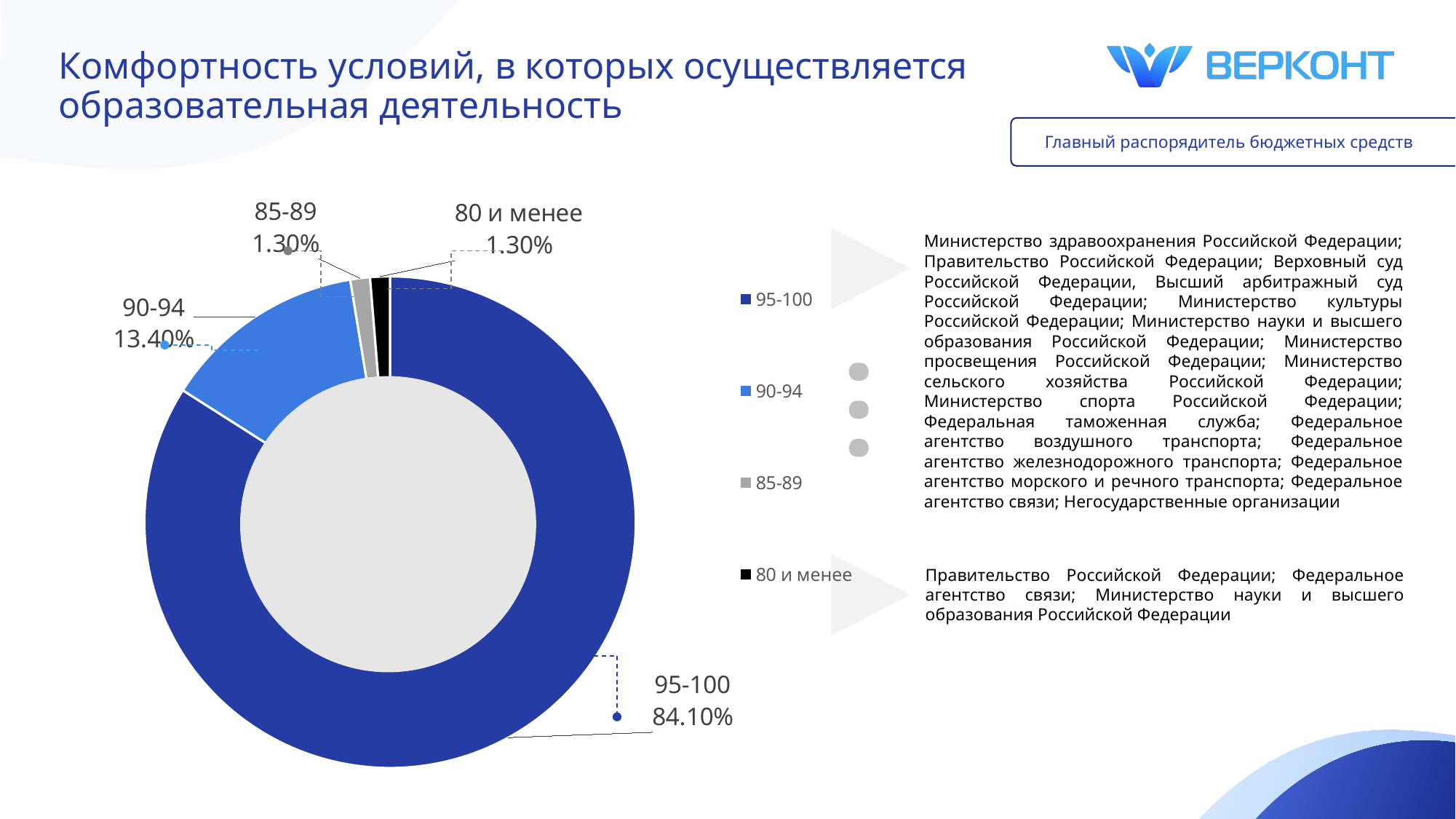
How many categories are shown in the chart? 4 How many entries does the chart legend list? 4 What is the difference between the shares of the 95-100 and 90-94 categories? 70.70% What colour is the slice for the '80 и менее' category? black What kind of chart is shown on the slide? doughnut chart What is the value shown for the 90-94 category? 13.40% What is the value shown for the 85-89 category? 1.30% What share of the pie does the 95-100 category hold? 84.10% What is the value shown for the '80 и менее' category? 1.30% Which category has a larger share, 90-94 or 85-89? 90-94 Which category has the largest share of the chart? 95-100 What colour is the slice for the 95-100 category? dark blue